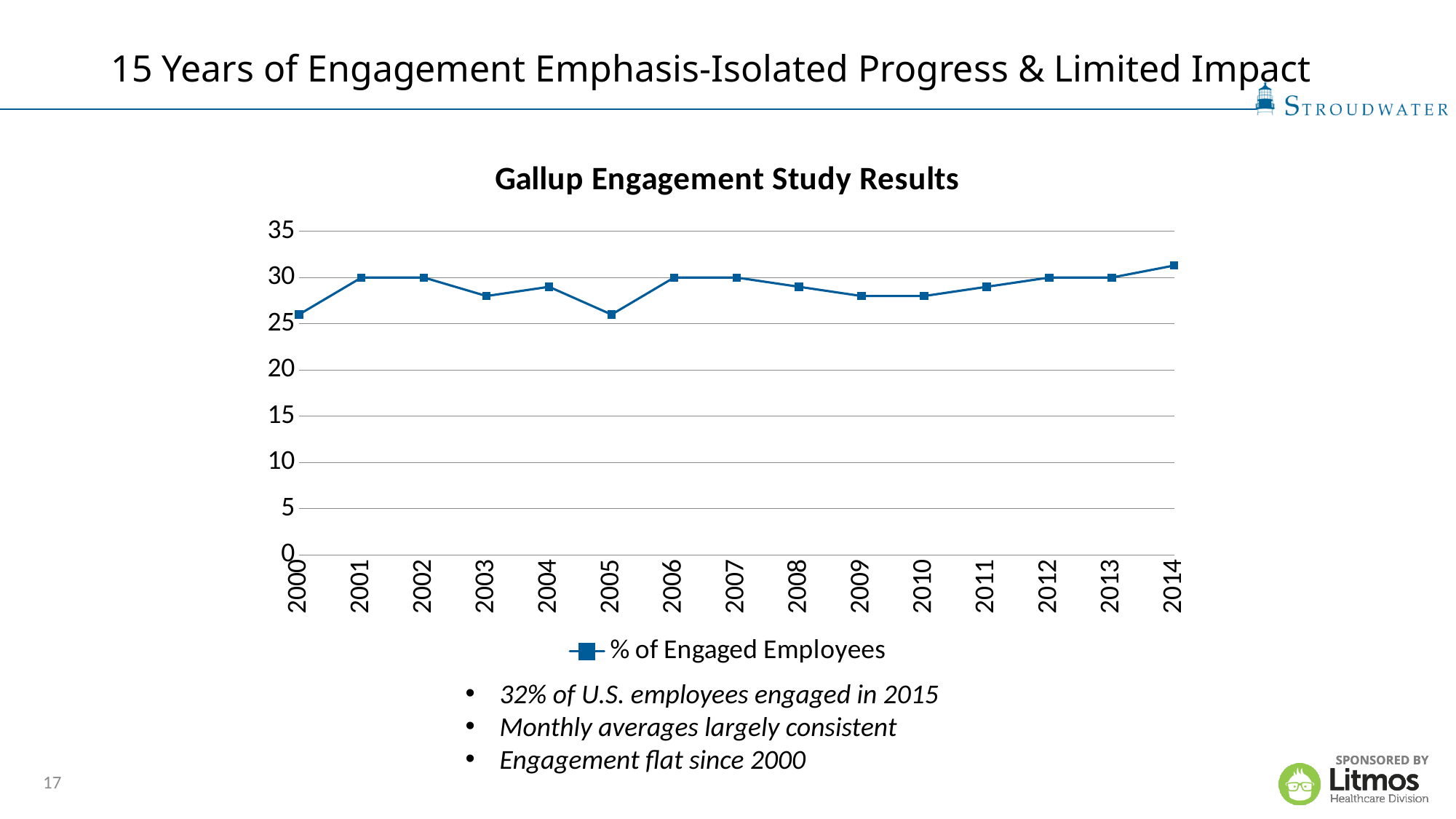
Is the value for 2009 greater or less than 25? greater How many series does the legend list? 1 What is the name of the series shown in the legend? % of Engaged Employees Which year has the larger value, 2014 or 2000? 2014 Is the value for 2000 greater or less than 30? less Is the value for 2005 greater or less than 30? less Which year has the highest value for % of Engaged Employees? 2014 What type of chart is shown on the slide? line chart Which year has the larger value, 2001 or 2005? 2001 What is the title of the chart? Gallup Engagement Study Results Do the values rise or fall from 2010 to 2014? rise How many years are plotted on the x axis? 15